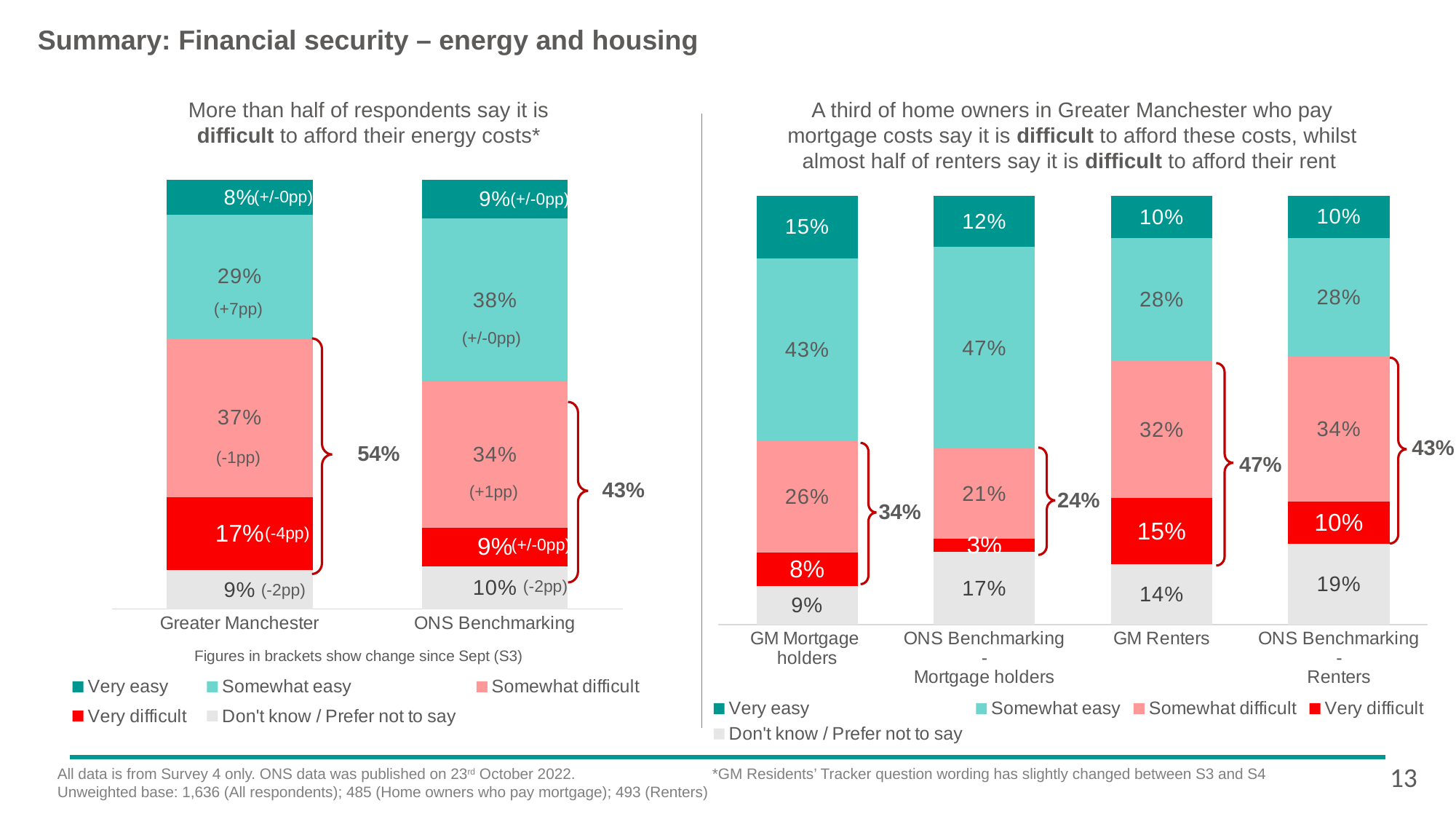
In the right chart (housing costs), what is the Somewhat easy value for ONS Benchmarking - Mortgage holders? 47% In the left chart (energy costs), what is the Somewhat easy value for ONS Benchmarking? 38% In the right chart (housing costs), how many categories are shown on the x axis? 4 In the right chart (housing costs), which category has the highest Don't know / Prefer not to say value? ONS Benchmarking - Renters In the left chart (energy costs), what combined share of Greater Manchester respondents say it is difficult (somewhat or very) to afford energy costs, as shown by the bracket? 54% In the left chart (energy costs), which has the larger Very difficult value, Greater Manchester or ONS Benchmarking? Greater Manchester In the right chart (housing costs), which category has the lowest Very difficult value? ONS Benchmarking - Mortgage holders What type of chart is used on the right side of the slide? Stacked bar chart In the right chart (housing costs), what percentage of GM Renters say it is very difficult to afford their rent? 15% In the left chart (energy costs), what percentage of Greater Manchester respondents say it is very difficult to afford their energy costs? 17% In the left chart (energy costs), what is the difference between the Somewhat difficult values for Greater Manchester and ONS Benchmarking? 3 percentage points In the left chart (energy costs), how many series does the legend list? 5